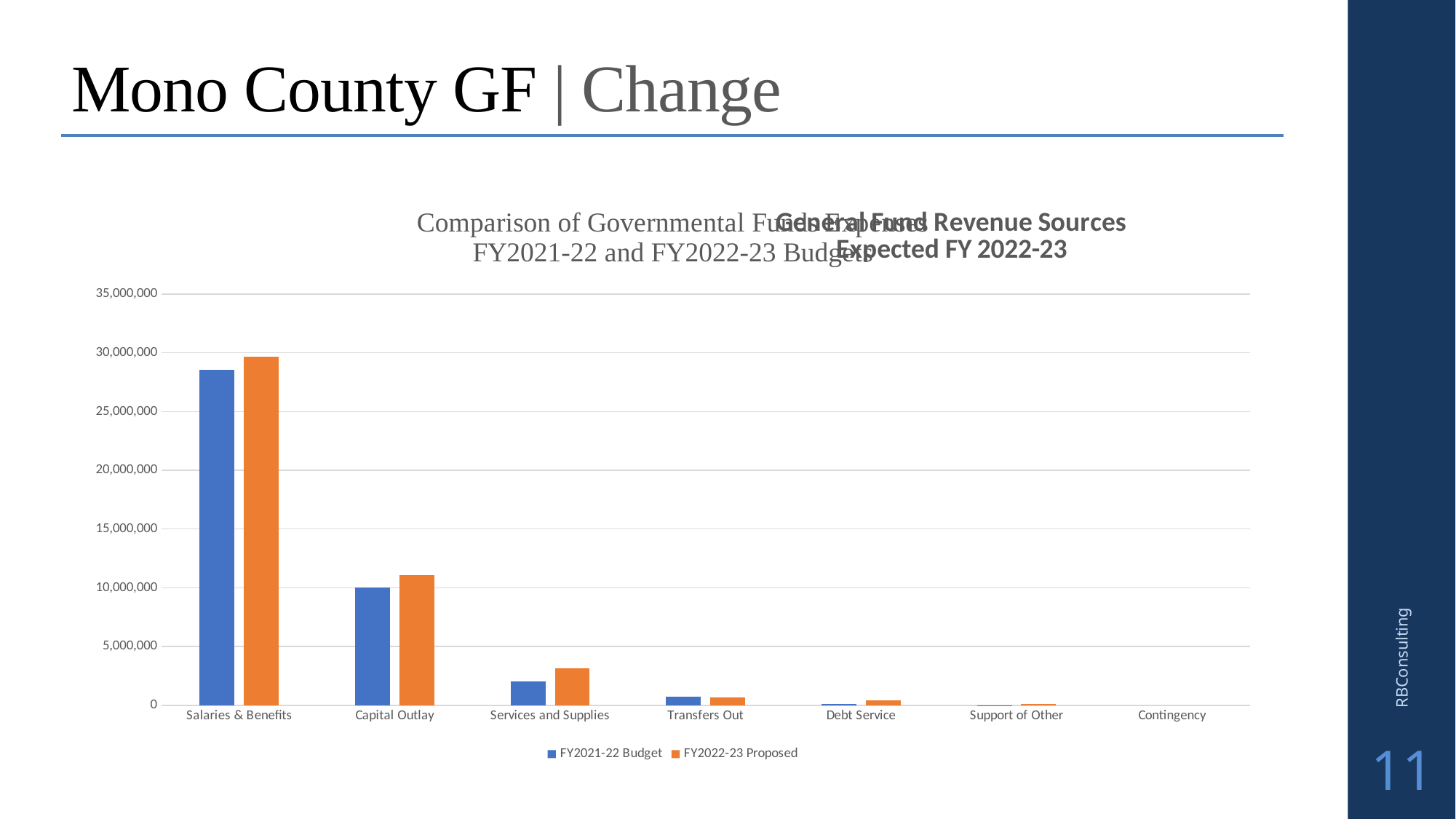
For Salaries & Benefits, which is larger: the FY2021-22 Budget or the FY2022-23 Proposed value? FY2022-23 Proposed Which colour represents the FY2022-23 Proposed series in the legend? Orange Is the FY2022-23 Proposed value for Services and Supplies greater or less than 5,000,000? less Is the FY2022-23 Proposed value for Capital Outlay greater or less than 10,000,000? greater For Services and Supplies, which is larger: the FY2021-22 Budget or the FY2022-23 Proposed value? FY2022-23 Proposed Do the bar values generally rise or fall moving from left to right along the x axis? fall How many series does the chart legend list? 2 Which category has the highest FY2022-23 Proposed value? Salaries & Benefits How many categories are shown along the x axis of the chart? 7 Is the FY2021-22 Budget value for Salaries & Benefits greater or less than 25,000,000? greater What kind of chart is shown on the slide? Bar chart Which category has the lowest values in the chart? Contingency